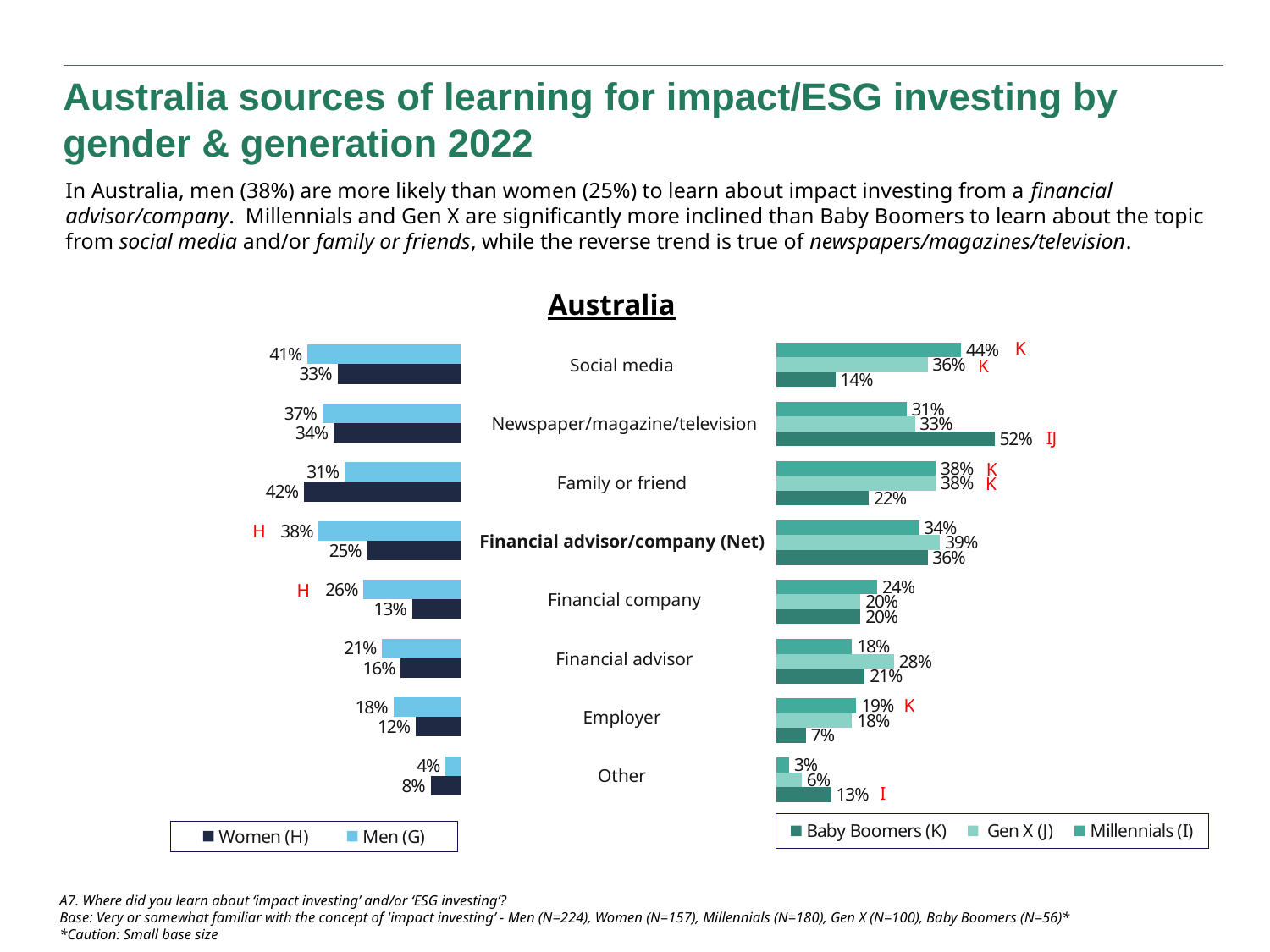
In the left chart (gender), what percentage of women learn about impact investing from family or friends? 42% In the left chart (gender), what is the difference between men and women for Financial company? 13% What type of chart is used on the left side of the slide? Bar chart In the right chart (generation), what percentage of Baby Boomers learn from newspaper/magazine/television? 52% In the left chart (gender), what percentage of men learn about impact investing from social media? 41% In the right chart (generation), what is the difference between Millennials and Baby Boomers for social media? 30% In the left chart (gender), which source has the highest value for women? Family or friend In the right chart (generation), what percentage of Gen X learn from a financial advisor? 28% How many series does the legend of the right chart (generation) list? 3 In the left chart (gender), which is larger for Other: men or women? Women In the left chart (gender), which source has the lowest value for men? Other In the right chart (generation), which generation has the lowest value for social media? Baby Boomers